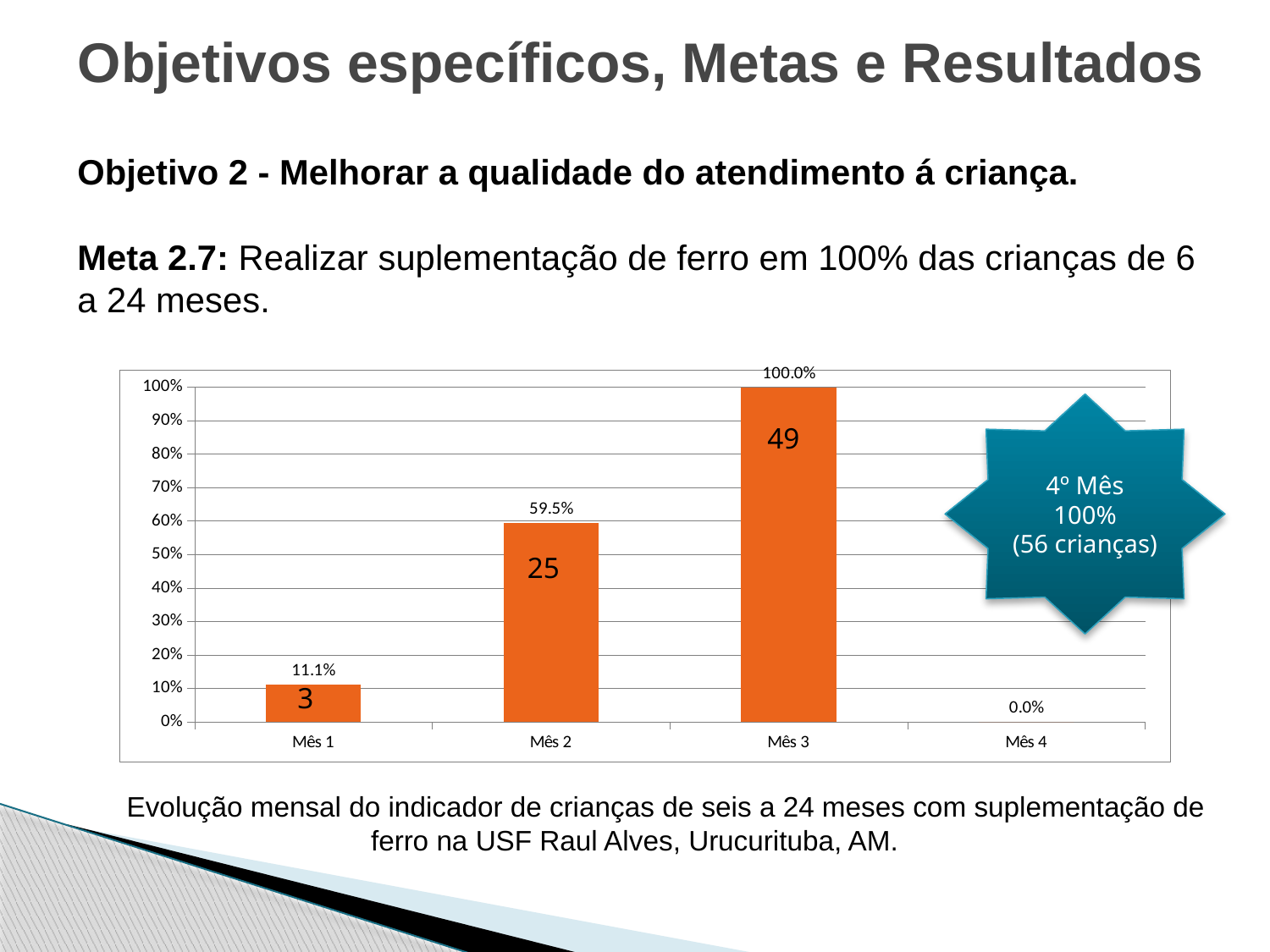
What percentage is shown for Mês 1? 11.1% Which is larger, the percentage for Mês 1 or for Mês 2? Mês 2 What percentage is shown for Mês 2? 59.5% What percentage is shown for Mês 3? 100.0% What kind of chart is shown on the slide? Bar chart What number is printed inside the bar for Mês 3? 49 What number is printed inside the bar for Mês 2? 25 What percentage does the star-shaped callout give for the 4º Mês? 100% Which month has the lowest percentage in the chart? Mês 4 What is the difference in percentage points between Mês 3 and Mês 2? 40.5 How many months (categories) are shown on the x axis? 4 Which month has the highest percentage in the chart? Mês 3